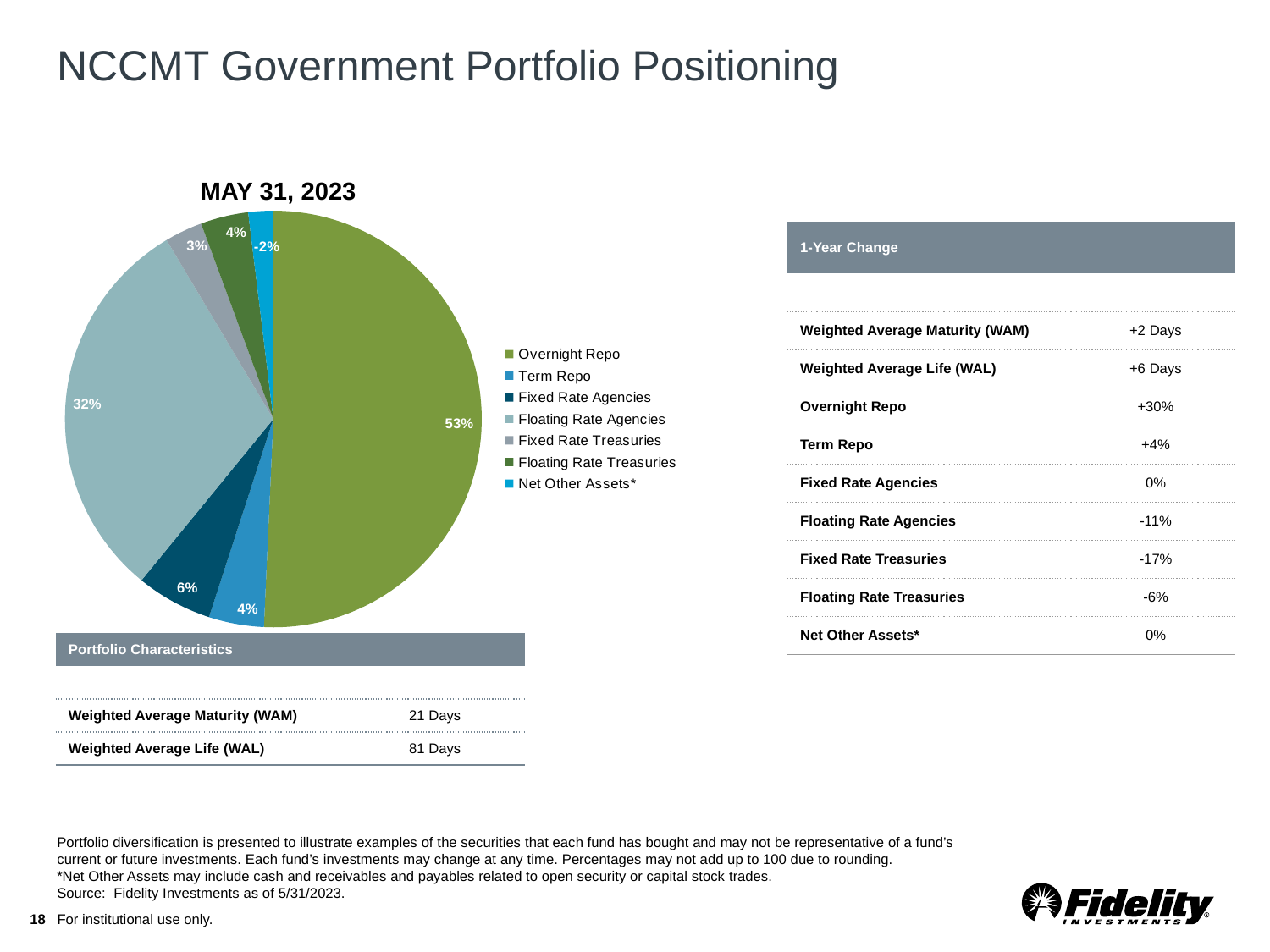
Which category has the smallest value in the pie chart? Net Other Assets* What percentage of the portfolio is Fixed Rate Agencies? 6% What percentage of the portfolio is Overnight Repo? 53% How many categories does the pie chart legend list? 7 Which is larger, the share for Fixed Rate Agencies or the share for Term Repo? Fixed Rate Agencies What is the difference between the Overnight Repo share and the Floating Rate Agencies share? 21% What is the title of the pie chart? MAY 31, 2023 What kind of chart is shown on the slide? pie chart What percentage of the portfolio is Fixed Rate Treasuries? 3% What percentage of the portfolio is Floating Rate Agencies? 32% Which category has the largest share of the pie chart? Overnight Repo What value is shown for Net Other Assets* in the pie chart? -2%